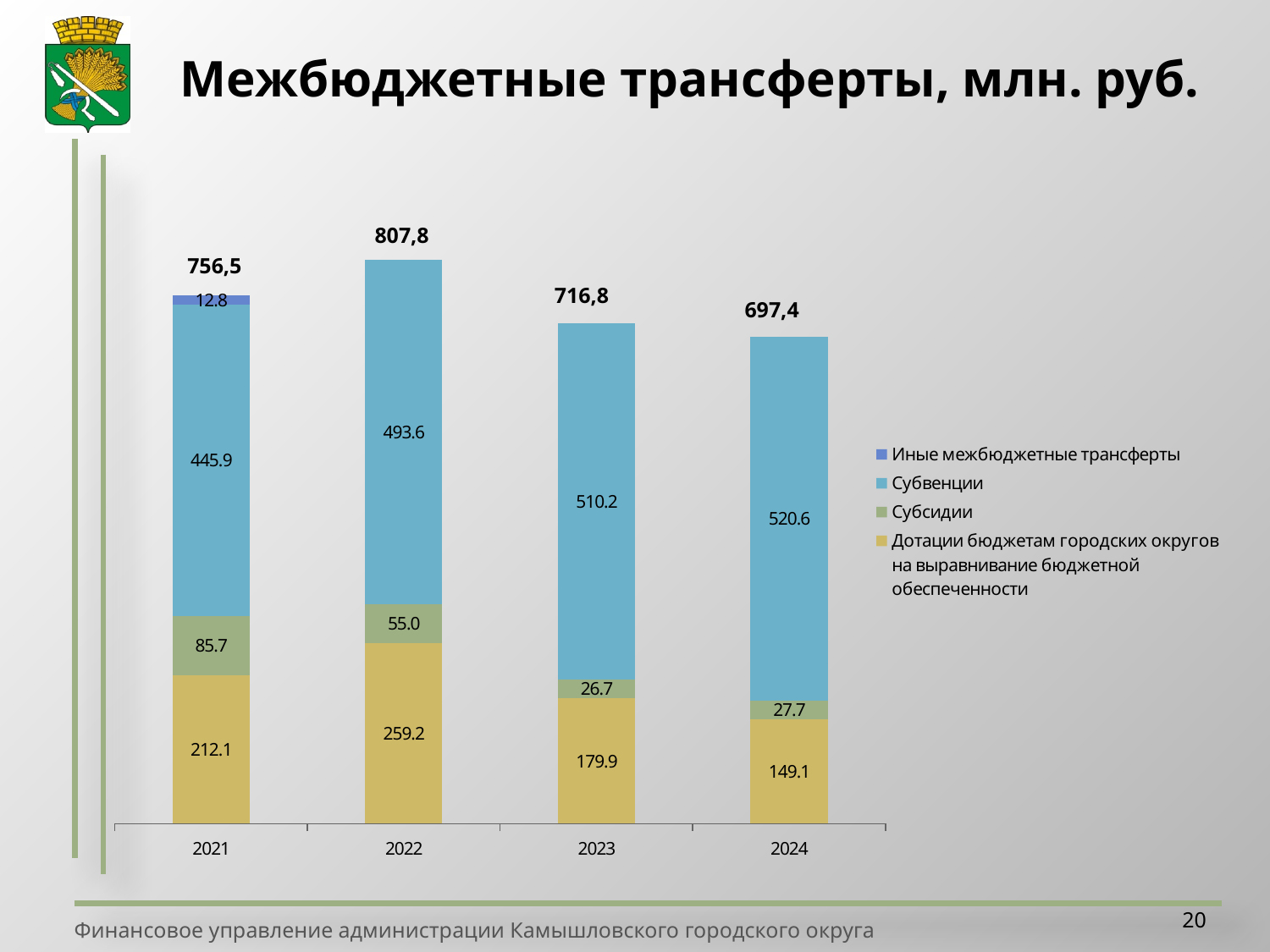
What is the value of Субвенции for 2023? 510.2 What is the value of Иные межбюджетные трансферты for 2021? 12.8 Which is larger: Субсидии in 2022 or Субсидии in 2024? Субсидии in 2022 What is the difference between the Субвенции values for 2024 and 2023? 10.4 Which year has the lowest total of межбюджетные трансферты? 2024 How many series does the legend list? 4 What is the value of Дотации бюджетам городских округов на выравнивание бюджетной обеспеченности for 2022? 259.2 What kind of chart is shown on the slide? Stacked bar chart What is the total of the stacked bar for 2022? 807,8 Which year has the highest total of межбюджетные трансферты? 2022 What is the value of Субсидии for 2021? 85.7 How many years are shown on the x axis? 4